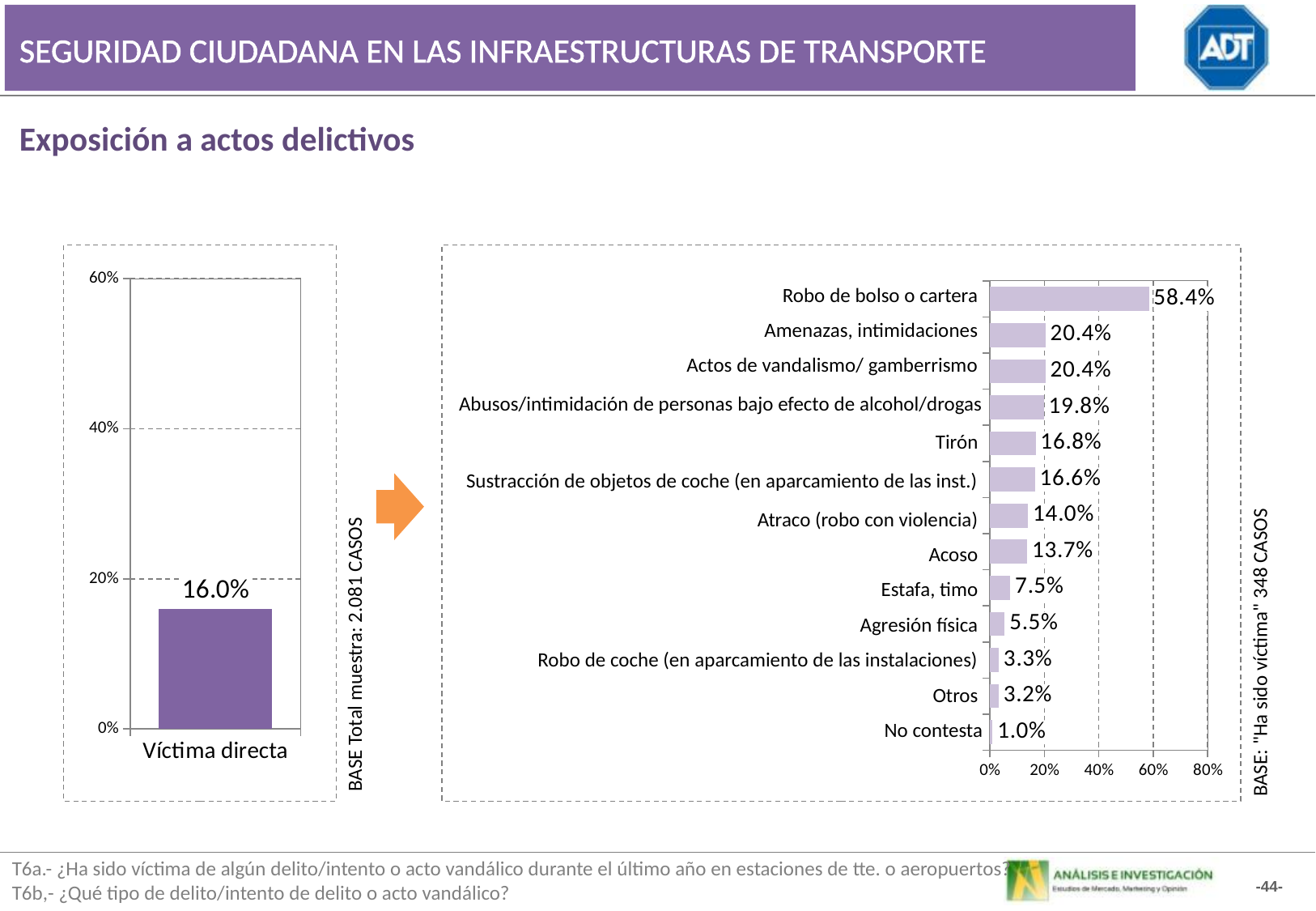
In the left chart, what is the value for Víctima directa? 16.0% In the right chart, what is the value for Robo de bolso o cartera? 58.4% In the right chart, which category has the lowest value? No contesta In the right chart, what is the value for Tirón? 16.8% In the right chart, is the value for Atraco (robo con violencia) greater or less than 20%? less What kind of chart is the left chart? bar chart In the right chart, which category has the highest value? Robo de bolso o cartera How many categories does the right chart show? 13 In the right chart, what is the value for Acoso? 13.7% In the right chart, which is larger: Estafa, timo or Agresión física? Estafa, timo In the right chart, what is the difference between Robo de bolso o cartera and Amenazas, intimidaciones? 38.0% In the left chart, is the value for Víctima directa greater or less than 20%? less